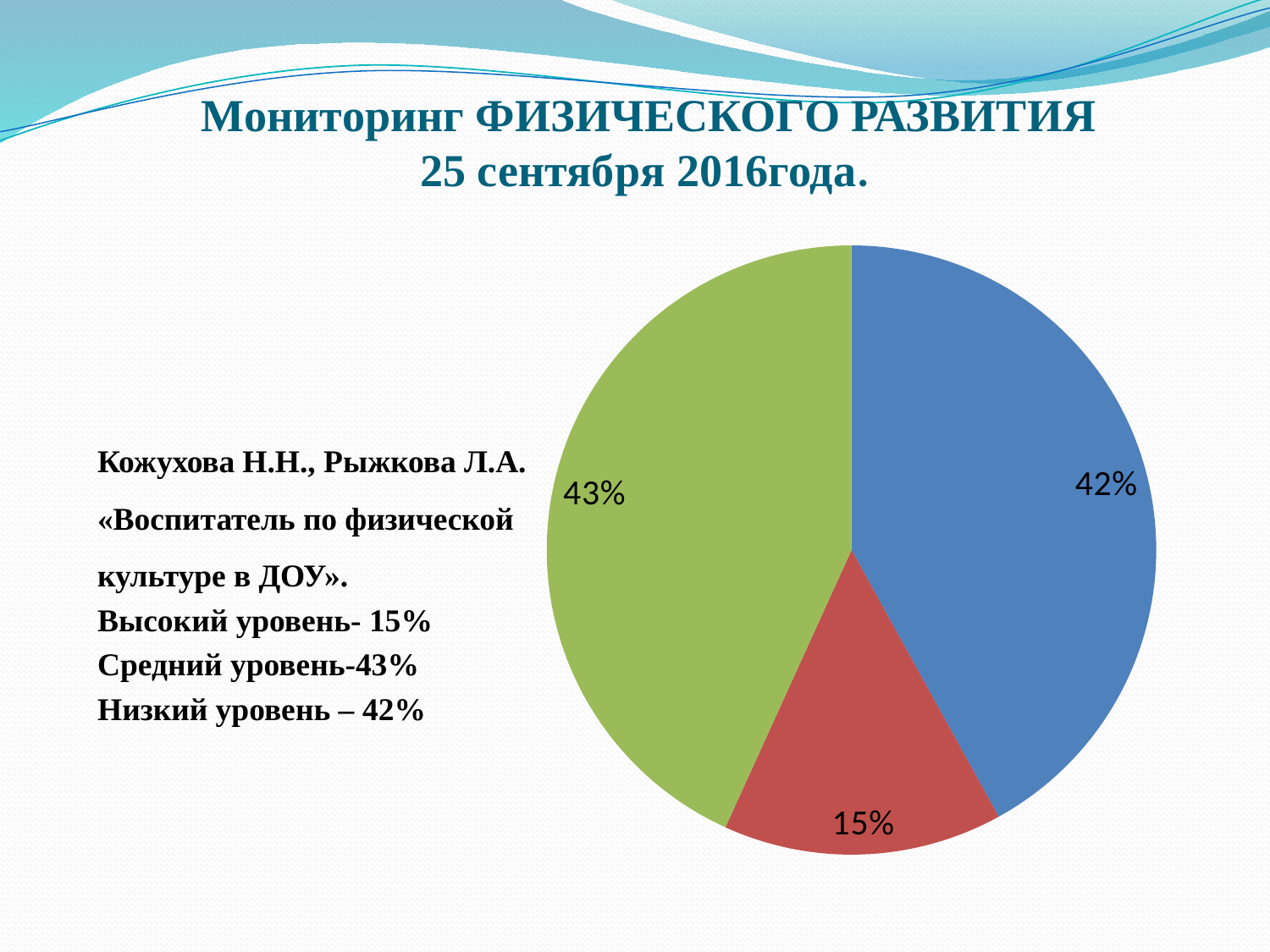
What is the title shown above the pie chart? Мониторинг ФИЗИЧЕСКОГО РАЗВИТИЯ 25 сентября 2016года. What is the difference between the green slice and the red slice of the pie chart? 28% According to the slide text, what percentage corresponds to 'Высокий уровень'? 15% Which slice of the pie chart has the largest printed value? the green slice (43%) What percentage is shown for the red slice of the pie chart? 15% What do the three slice values of the pie chart add up to? 100% Which slice of the pie chart is the smallest? the red slice (15%) What percentage is shown for the green slice of the pie chart? 43% Which is larger in the pie chart, the blue slice or the red slice? the blue slice What kind of chart is shown on the slide? pie chart How many slices does the pie chart have? 3 What percentage is shown for the blue slice of the pie chart? 42%